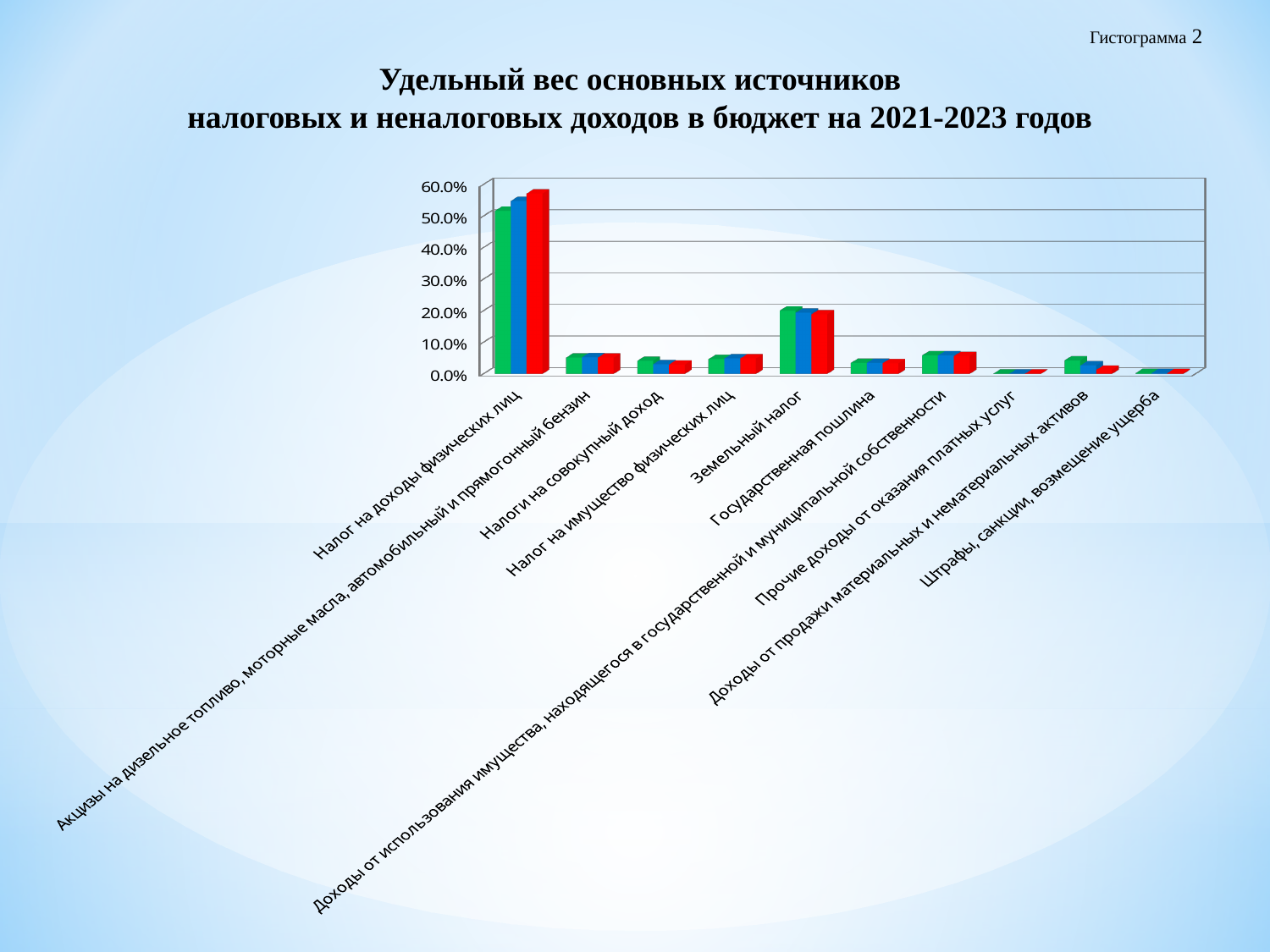
Is the red bar for Налог на доходы физических лиц greater or less than 50.0%? greater What is the highest value shown on the vertical axis of the chart? 60.0% Are the values for Налог на доходы физических лиц greater or less than 40.0%? greater Which category has the second-highest values in the chart? Земельный налог Which is larger: the value for Земельный налог or the value for Налог на имущество физических лиц? Земельный налог How many categories are shown on the x axis of the chart? 10 What kind of chart is shown on the slide? Bar chart Which is larger: the value for Налог на доходы физических лиц or the value for Земельный налог? Налог на доходы физических лиц Which category has the highest values in the chart? Налог на доходы физических лиц Do the three bars for Налог на доходы физических лиц rise or fall from the green bar to the red bar? rise Are the values for Земельный налог greater or less than 30.0%? less